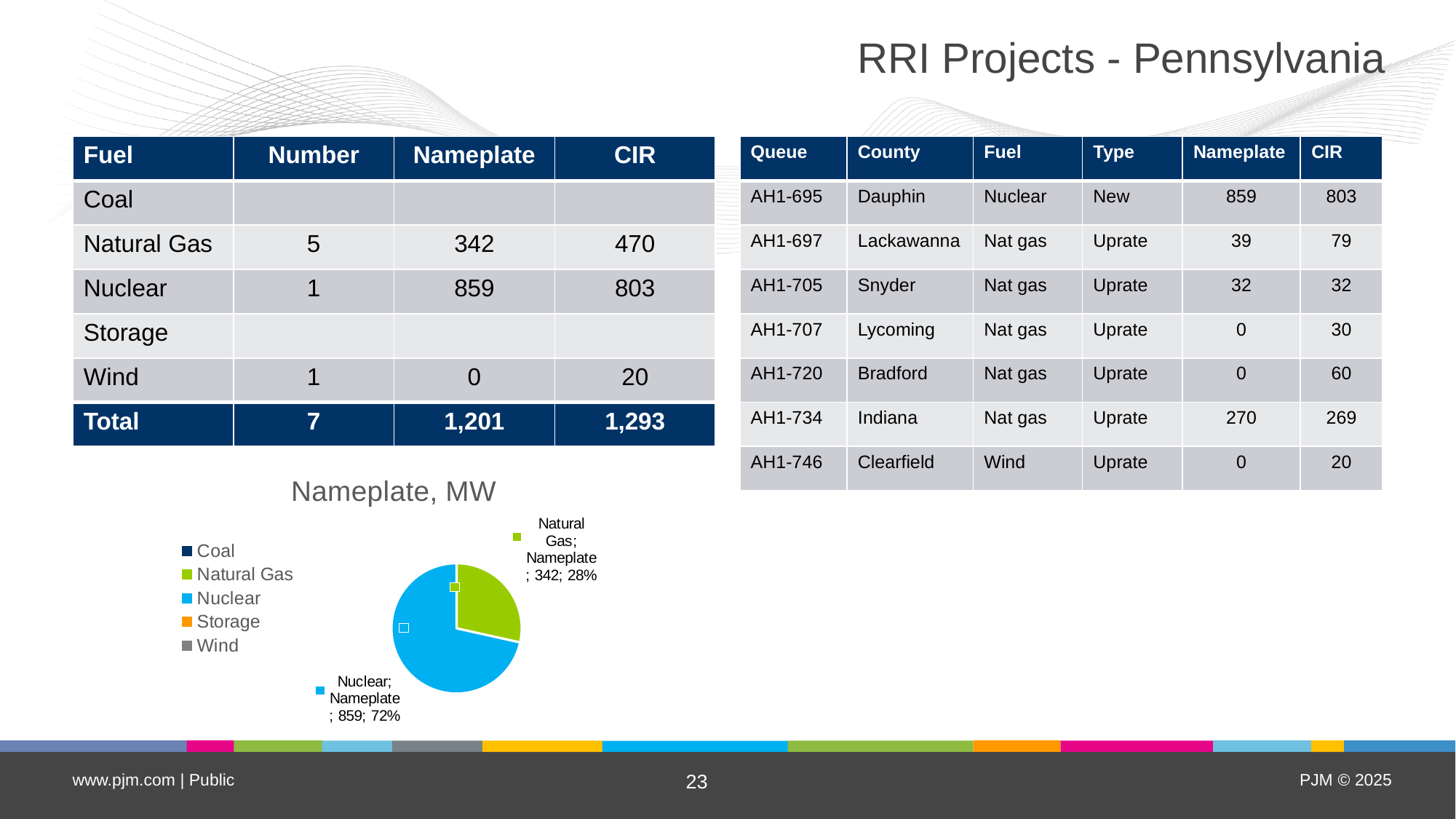
What is the Nameplate value for Nuclear in the pie chart? 859 What is the title of the chart? Nameplate, MW What colour is the Nuclear slice in the pie chart? light blue What kind of chart is shown on the slide? pie chart What share of the pie does Nuclear represent? 72% How many slices with data labels are visible in the pie chart? 2 What is the difference between the Nuclear and Natural Gas Nameplate values shown in the pie chart? 517 Which is larger in the pie chart, the Nuclear slice or the Natural Gas slice? Nuclear What is the Nameplate value for Natural Gas in the pie chart? 342 What share of the pie does Natural Gas represent? 28% How many entries does the chart's legend list? 5 Which category has the largest slice in the pie chart? Nuclear